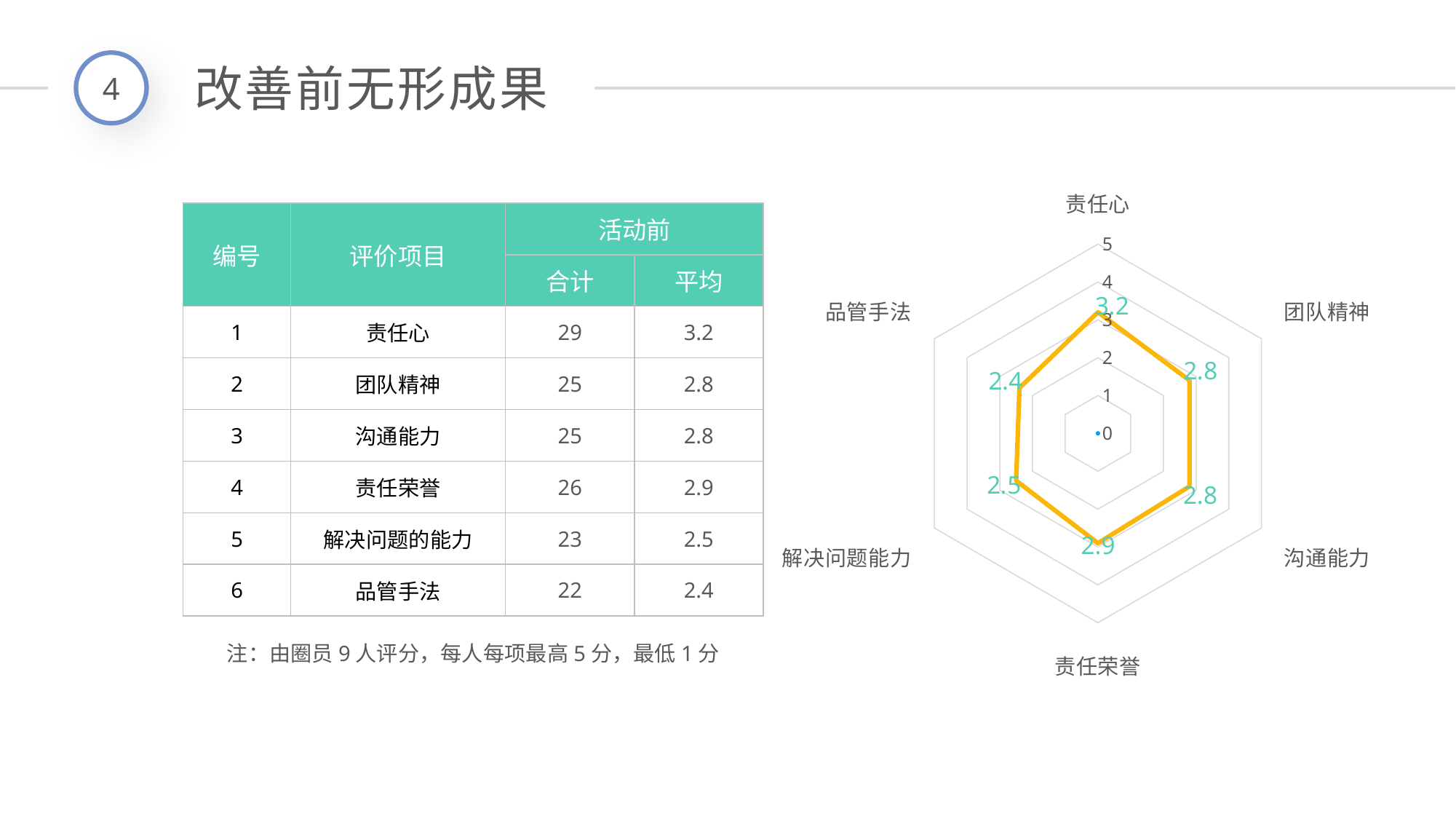
What is the maximum value shown on the radar chart's axis scale? 5 Is the value for 责任心 in the radar chart greater or less than 3? greater Which category has the highest value in the radar chart? 责任心 What is the difference between the values for 责任心 and 品管手法 in the radar chart? 0.8 What kind of chart is shown on the slide? radar chart What is the value for 责任荣誉 in the radar chart? 2.9 Which category has the lowest value in the radar chart? 品管手法 What is the value for 责任心 in the radar chart? 3.2 Which is larger in the radar chart, the value for 责任荣誉 or the value for 解决问题能力? 责任荣誉 What is the value for 品管手法 in the radar chart? 2.4 How many categories are plotted in the radar chart? 6 What is the value for 解决问题能力 in the radar chart? 2.5